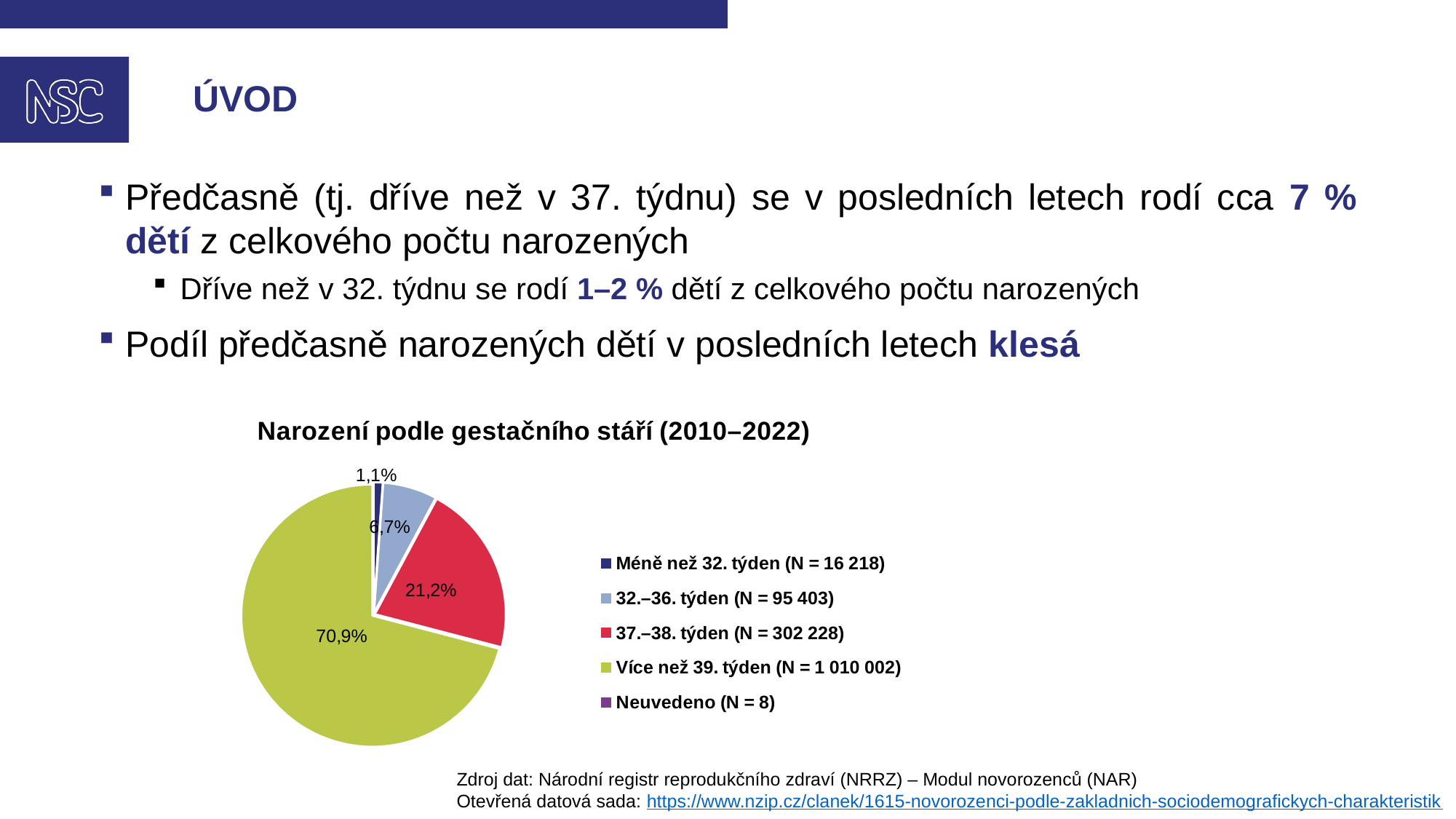
Which slice is larger: '32.–36. týden' or '37.–38. týden'? 37.–38. týden Which category has the largest slice of the pie? Více než 39. týden What is the difference in percentage points between the 'Více než 39. týden' slice and the '37.–38. týden' slice? 49,7 What is the N value given in the legend for the category '37.–38. týden'? 302 228 How many categories does the legend of the pie chart list? 5 What is the title of the chart? Narození podle gestačního stáří (2010–2022) Which category has the smallest N according to the legend? Neuvedeno (N = 8) What kind of chart is shown on the slide? Pie chart What share of the pie does the category '32.–36. týden' represent? 6,7% What share of the pie does the category 'Více než 39. týden' represent? 70,9% What share of the pie does the category 'Méně než 32. týden' represent? 1,1%